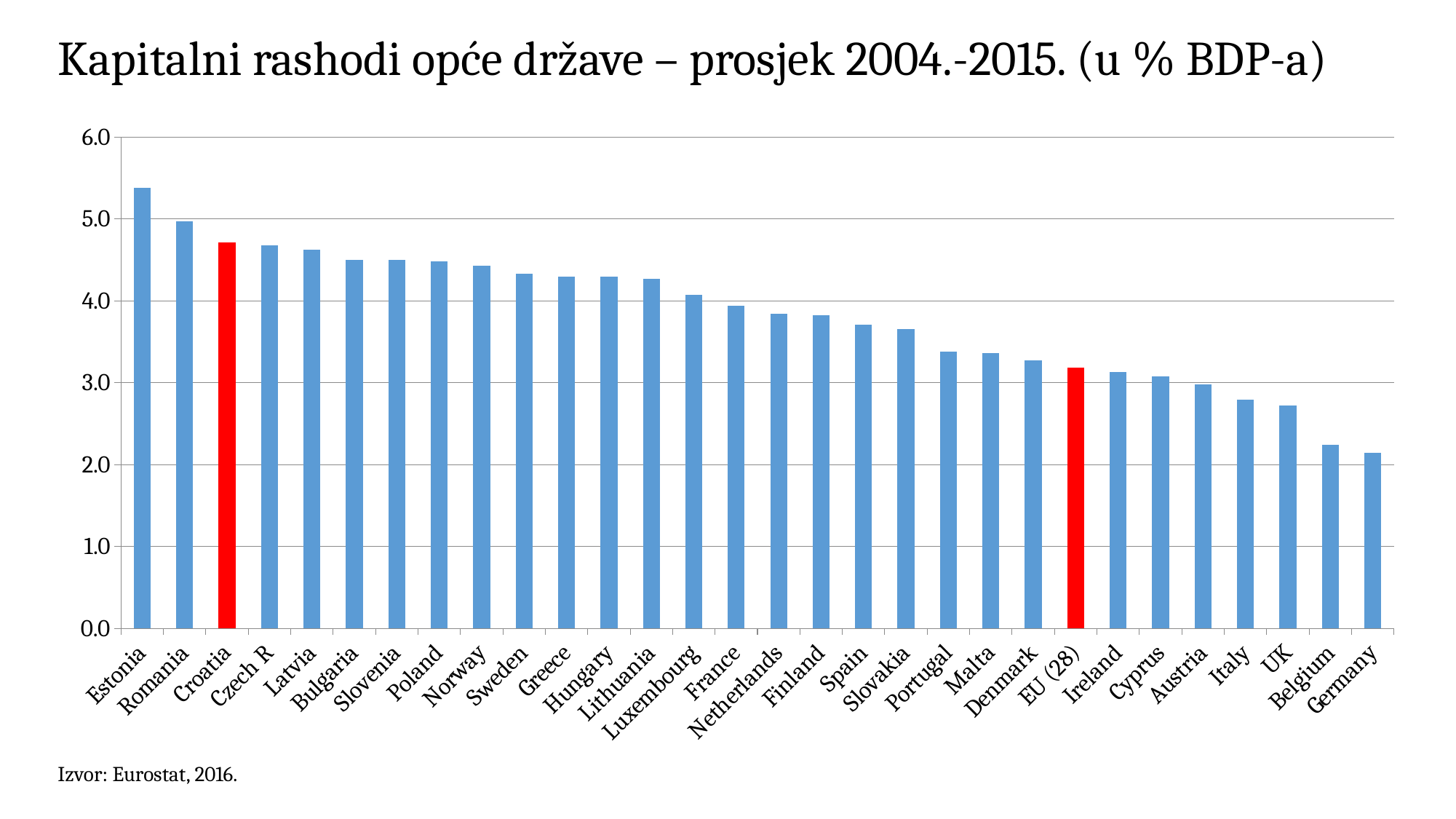
Is the value for Estonia greater or less than 5.0? greater Is the value for Croatia greater or less than 4.0? greater Do the values rise or fall moving from left to right along the x axis? fall Which has the larger value, Croatia or EU (28)? Croatia How many categories (bars) are shown in the chart? 30 What kind of chart is shown on the slide? bar chart Which country has the highest capital expenditure value in the chart? Estonia Is the value for Spain greater or less than 3.0? greater Which country has the lowest value in the chart? Germany Which two bars are highlighted in red? Croatia and EU (28)